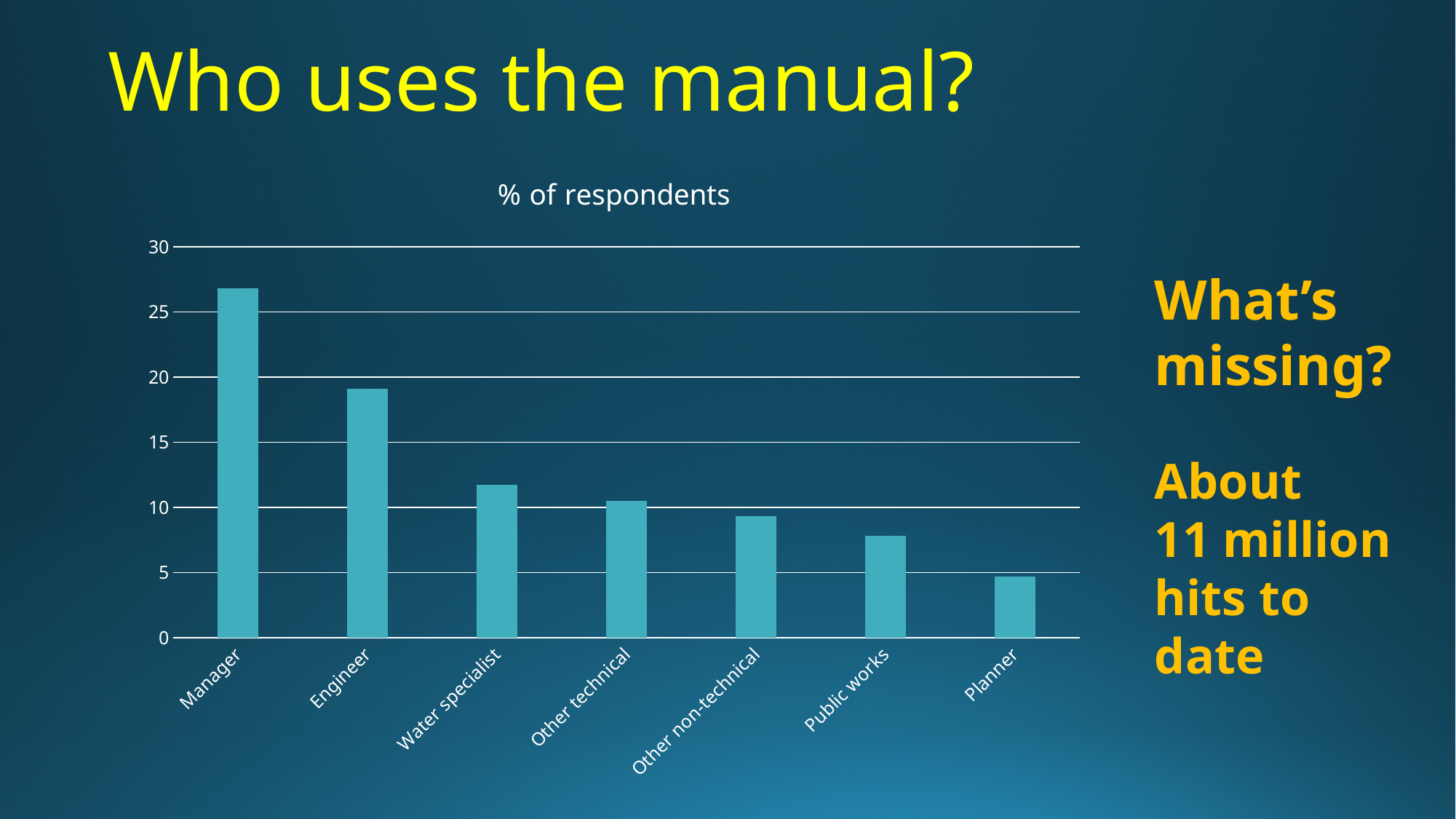
Which is larger, the value for Water specialist or the value for Public works? Water specialist Do the values rise or fall from left to right along the x axis? Fall Is the value for Manager greater or less than 25? greater Which is larger, the value for Manager or the value for Engineer? Manager Is the value for Water specialist greater or less than 10? greater Is the value for Public works greater or less than 10? less How many categories are shown on the x axis of the chart? 7 Which category has the highest value in the chart? Manager Which category has the lowest value in the chart? Planner What is the title of the chart? % of respondents What kind of chart is shown on the slide? Bar chart